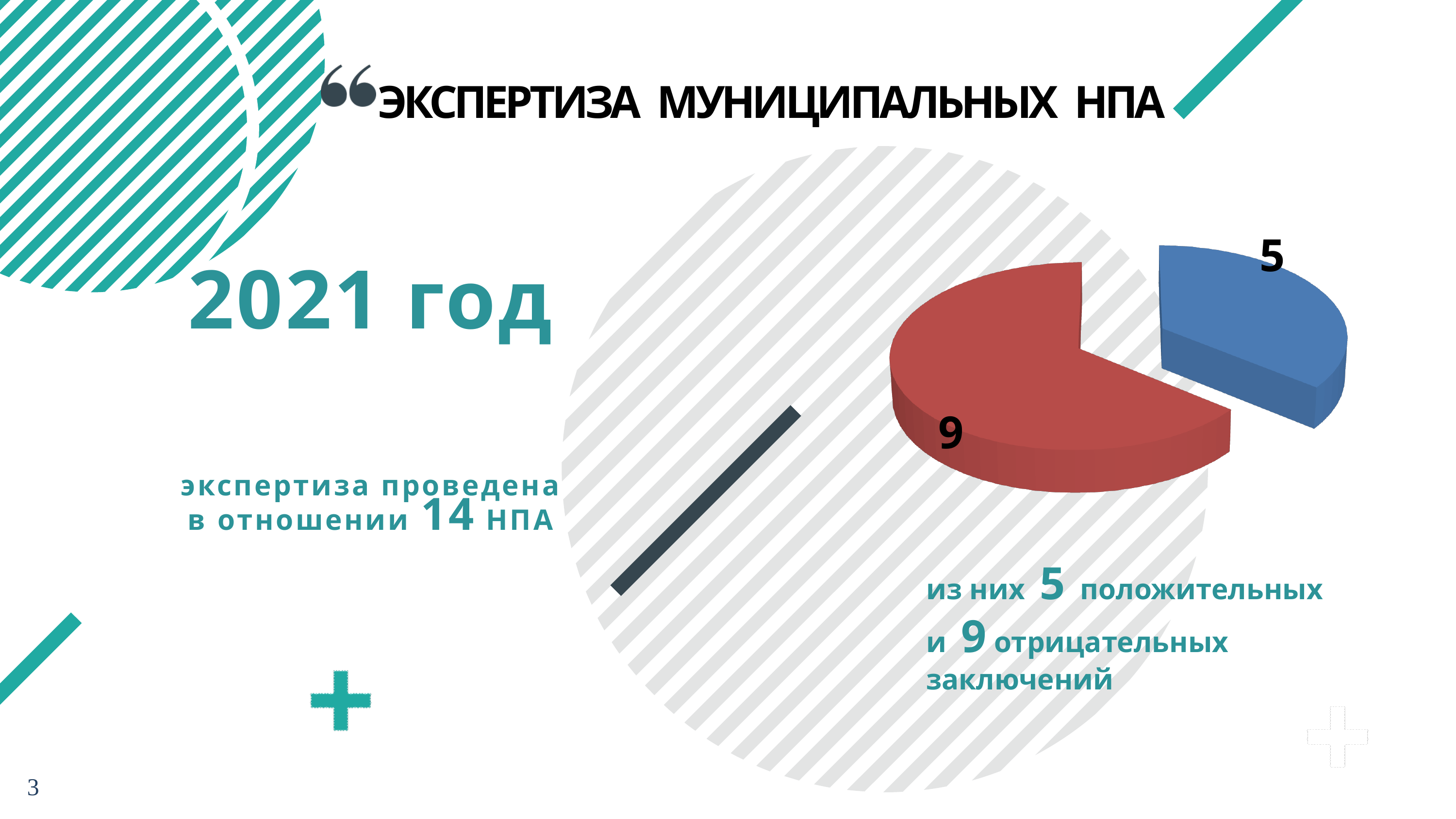
What kind of chart is shown on the slide? pie chart What colour is the slice labelled 5 in the pie chart? blue What value is labelled on the blue slice of the pie chart? 5 According to the slide, how many positive (положительных) conclusions are shown in the pie chart? 5 What value is labelled on the red slice of the pie chart? 9 What is the total of the two slice values in the pie chart? 14 How many slices does the pie chart have? 2 Which slice of the pie chart is the smallest? the blue slice (5) Which is larger in the pie chart, the red slice or the blue slice? the red slice What is the difference between the red slice value and the blue slice value in the pie chart? 4 According to the slide, how many negative (отрицательных) conclusions are shown in the pie chart? 9 Which slice of the pie chart is the largest? the red slice (9)